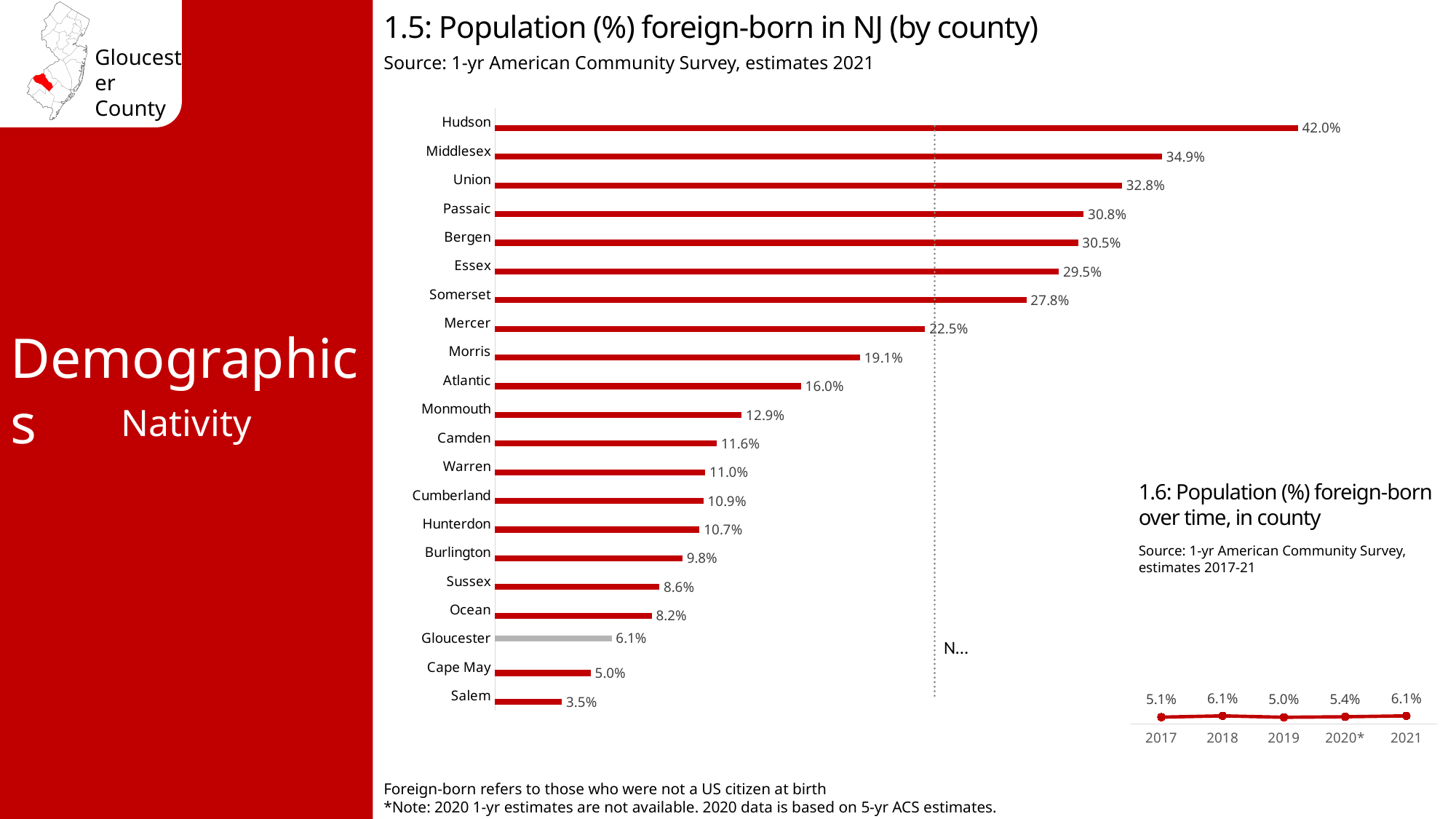
In chart 1.6 (Population (%) foreign-born over time, in county), what is the value for 2019? 5.0% In chart 1.5 (Population (%) foreign-born in NJ by county), which county has the highest value? Hudson In chart 1.5 (Population (%) foreign-born in NJ by county), what is the value for Gloucester? 6.1% In chart 1.5 (Population (%) foreign-born in NJ by county), which is larger, Camden or Burlington? Camden In chart 1.5 (Population (%) foreign-born in NJ by county), which county has the lowest value? Salem In chart 1.6 (Population (%) foreign-born over time, in county), how many data points are plotted? 5 In chart 1.5 (Population (%) foreign-born in NJ by county), which county's bar is shown in grey instead of red? Gloucester In chart 1.6 (Population (%) foreign-born over time, in county), what is the difference between 2021 and 2017? 1.0% What kind of chart is chart 1.5 (Population (%) foreign-born in NJ by county)? Bar chart In chart 1.5 (Population (%) foreign-born in NJ by county), what is the value for Middlesex? 34.9% In chart 1.5 (Population (%) foreign-born in NJ by county), what is the difference between Hudson and Salem? 38.5% In chart 1.5 (Population (%) foreign-born in NJ by county), how many counties are shown? 21